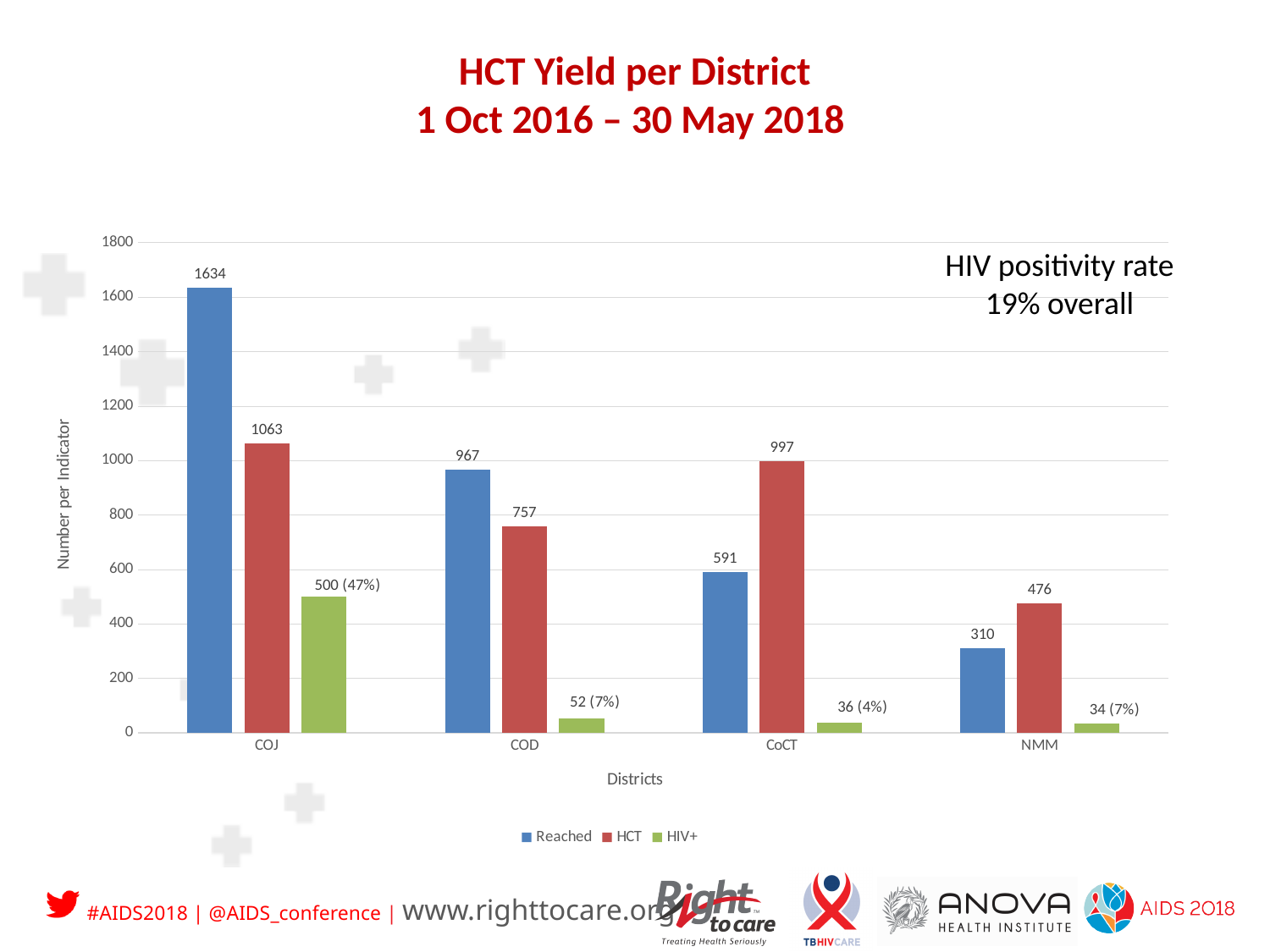
What is the difference between the Reached and HCT values for COJ? 571 What is the Reached value for COJ? 1634 Which is larger for CoCT, the Reached value or the HCT value? HCT What is the HCT value for CoCT? 997 Which district has the lowest HCT value? NMM What kind of chart is shown on the slide? bar chart How many districts are shown on the x axis? 4 What is the HIV+ data label for COD? 52 (7%) What is the overall HIV positivity rate stated on the slide? 19% Which district has the highest Reached value? COJ Is the HCT value for COD greater or less than 800? less How many series does the legend list? 3